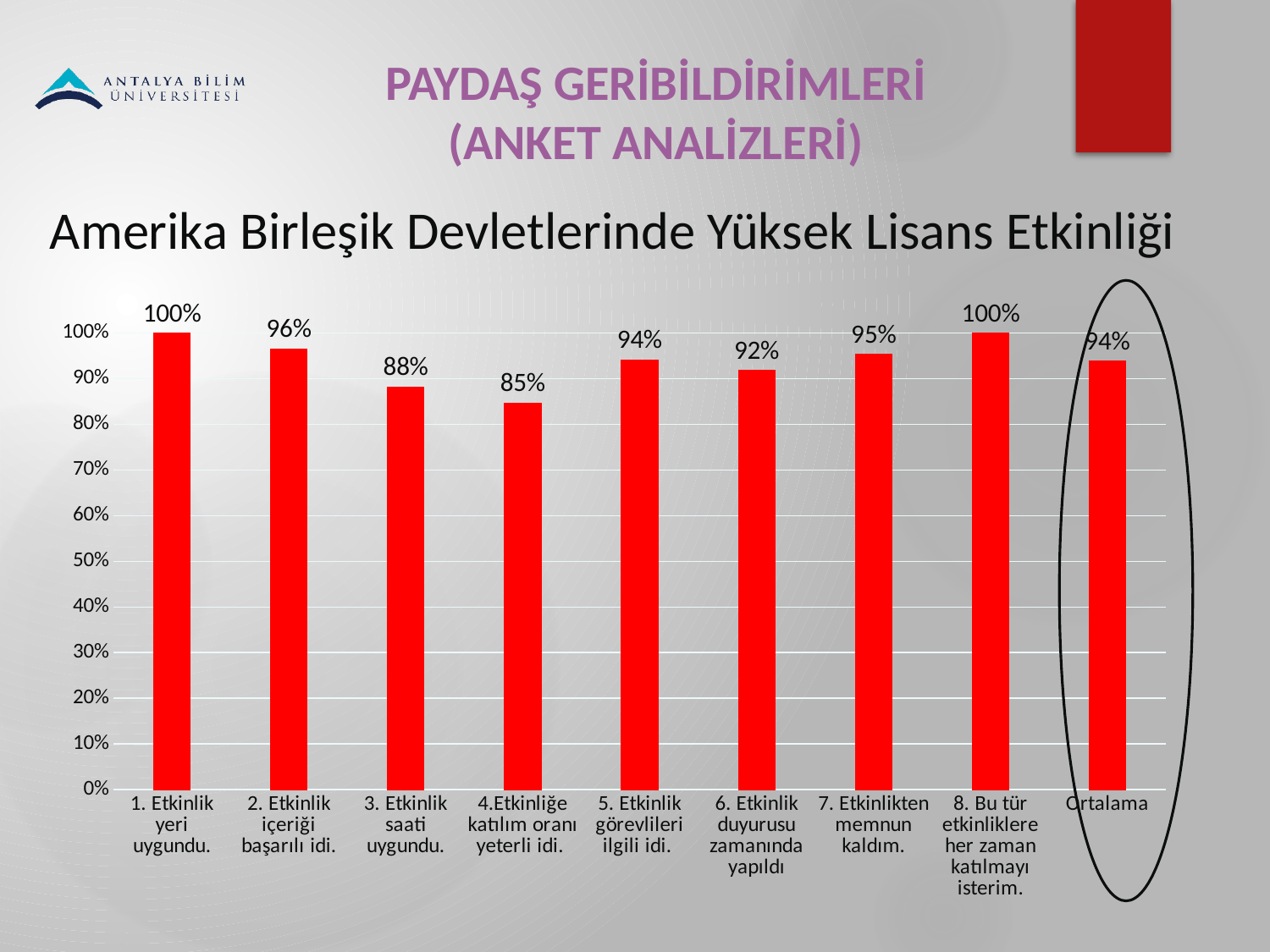
What is the difference between the highest value and the lowest value in the chart? 15% What is the value for "4.Etkinliğe katılım oranı yeterli idi."? 85% What is the difference between the values for "2. Etkinlik içeriği başarılı idi." and "3. Etkinlik saati uygundu."? 8% Which bar on the chart is circled? Ortalama What is the value for "6. Etkinlik duyurusu zamanında yapıldı"? 92% What is the value for "1. Etkinlik yeri uygundu."? 100% How many bars are plotted in the chart? 9 What colour are the bars in the chart? Red Which category has the lowest value? 4.Etkinliğe katılım oranı yeterli idi. Which is larger: the value for "5. Etkinlik görevlileri ilgili idi." or the value for "7. Etkinlikten memnun kaldım."? 7. Etkinlikten memnun kaldım. What is the value shown for "Ortalama"? 94% What type of chart is shown on the slide? Bar chart